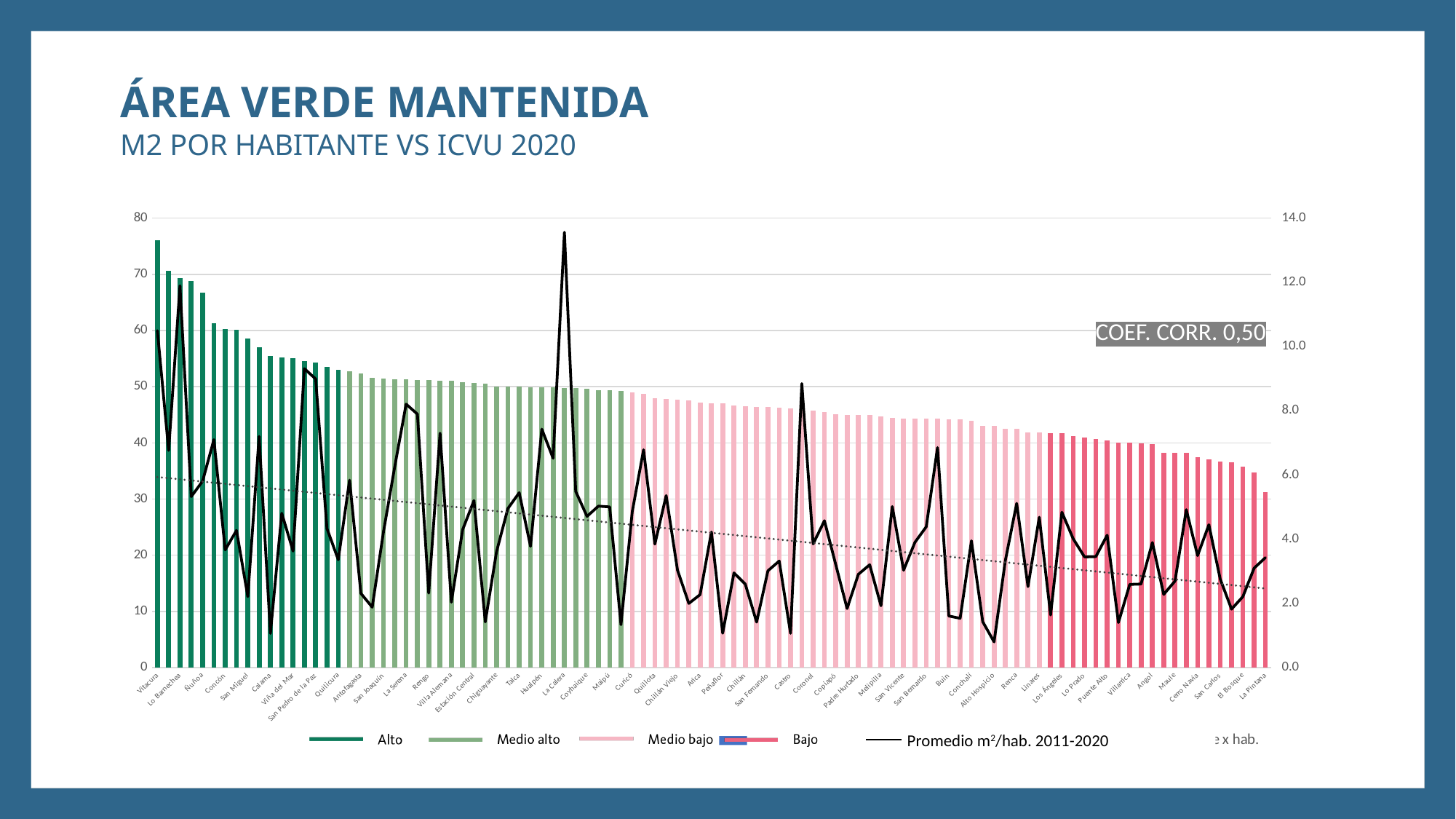
Is the bar value for La Pintana greater or less than 40? less Is the Promedio m²/hab. 2011-2020 line value for La Calera greater or less than 12.0 on the right axis? greater Is the bar value for Vitacura greater or less than 70? greater Which bar is taller, Vitacura or La Pintana? Vitacura Which comuna has the highest bar? Vitacura At which comuna does the Promedio m²/hab. 2011-2020 line reach its highest peak? La Calera How many entries does the legend list? 5 Which legend category is shown in dark green? Alto Do the bar values rise or fall from left to right along the x axis? fall What correlation coefficient is shown on the chart? 0,50 What kind of chart is shown on the slide? A bar chart combined with a line Which comuna has the lowest bar? La Pintana